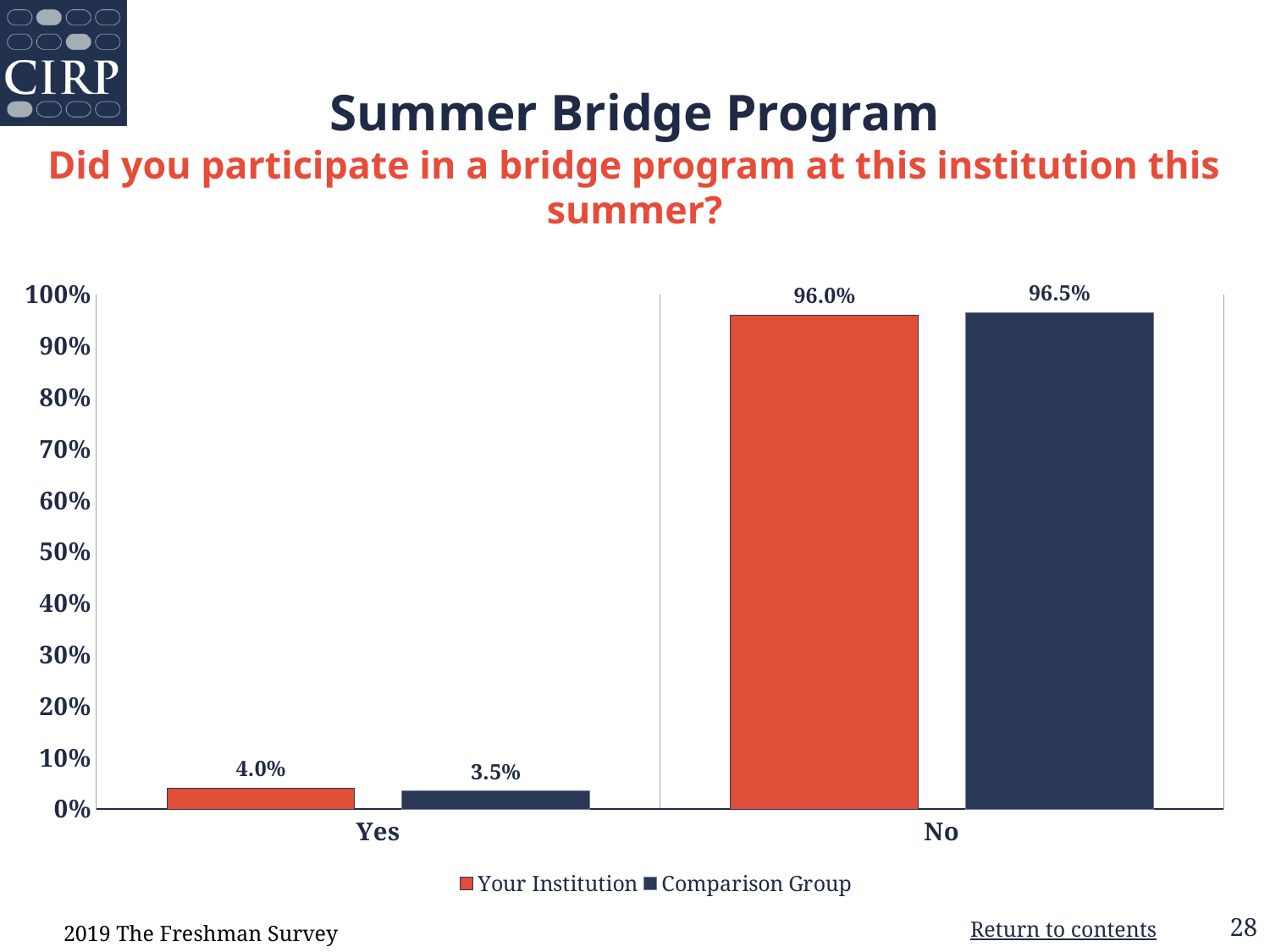
What is the value for Comparison Group in the Yes category? 3.5% What is the difference between Your Institution and Comparison Group in the No category? 0.5% What is the value for Your Institution in the No category? 96.0% What is the difference between Your Institution and Comparison Group in the Yes category? 0.5% How many series does the legend list? 2 What kind of chart is shown on the slide? bar chart Which category has the lowest value for Comparison Group? Yes What is the value for Your Institution in the Yes category? 4.0% Which category has the highest value for Your Institution? No Is the value for Your Institution in the No category greater or less than 90%? greater How many categories are shown on the x axis? 2 What is the value for Comparison Group in the No category? 96.5%